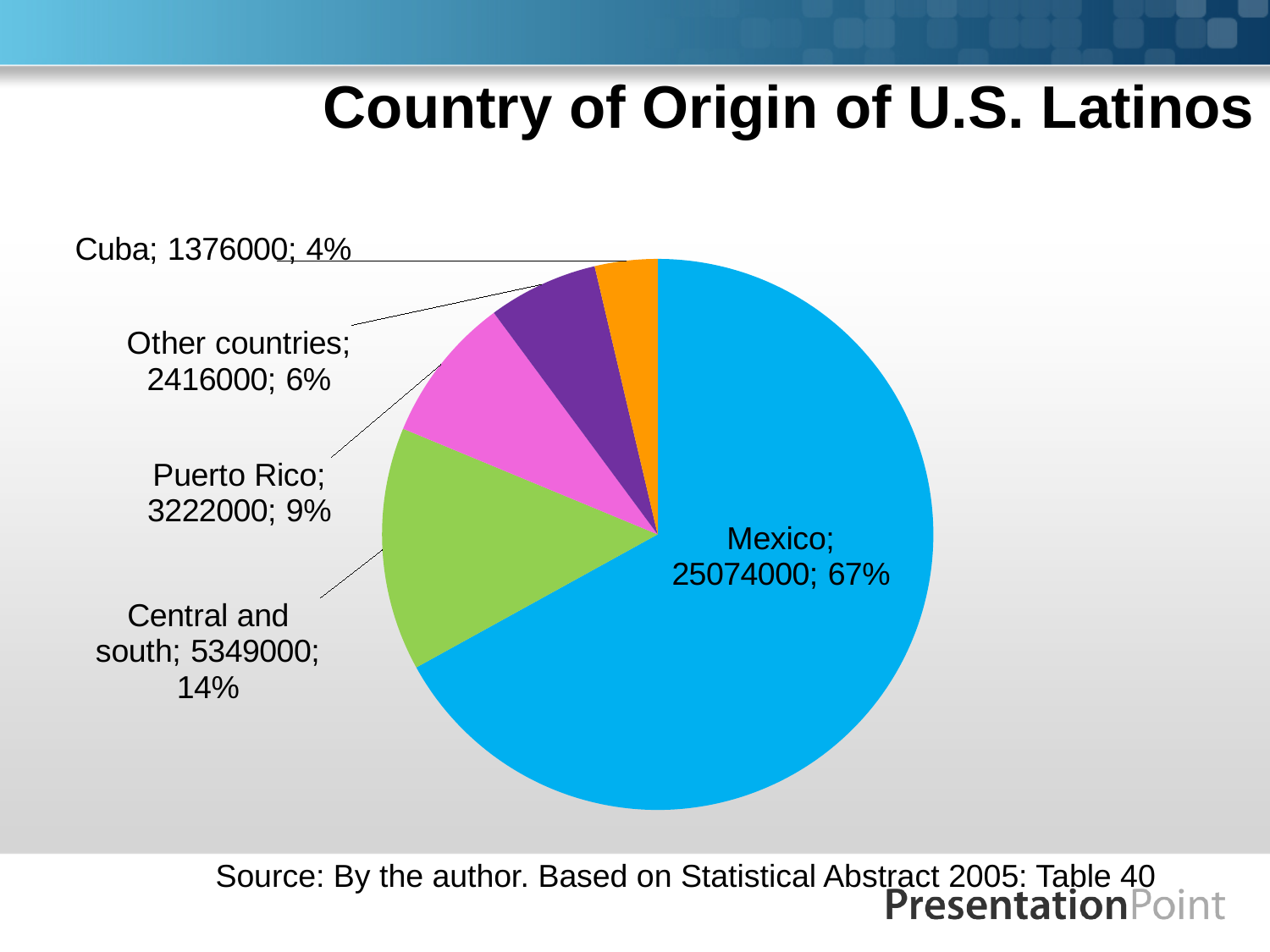
Which is larger, the value for Other countries or the value for Cuba? Other countries How many slices does the pie chart have? 5 What share of the pie does Central and south represent? 14% What kind of chart is shown on the slide? pie chart Which category has the smallest slice? Cuba What is the title of the chart? Country of Origin of U.S. Latinos What is the value for Mexico? 25074000 Which category has the largest slice? Mexico What is the difference between the values for Central and south and Puerto Rico? 2127000 What is the value for Cuba? 1376000 What is the value for Puerto Rico? 3222000 What share of the pie does Other countries represent? 6%